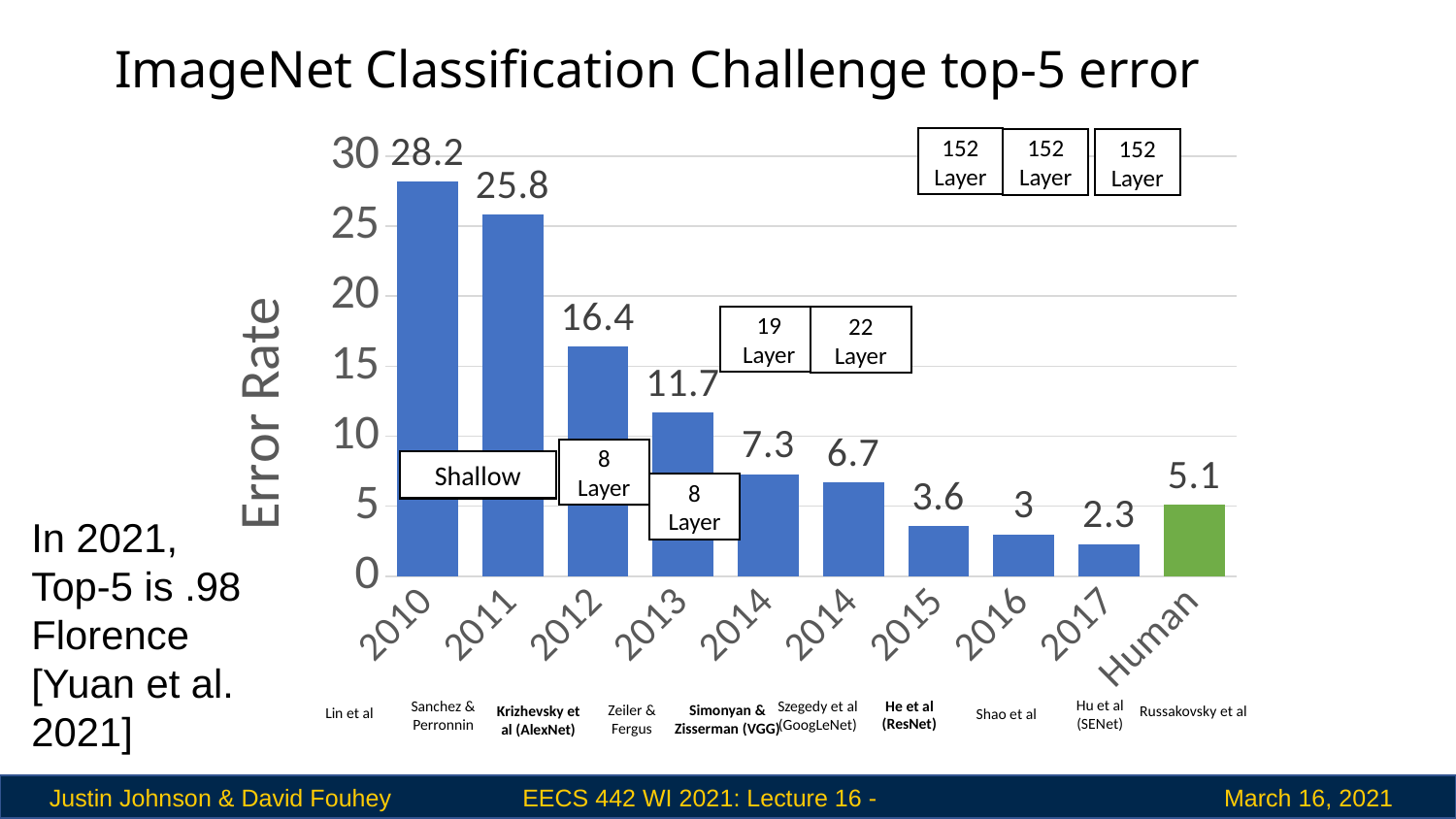
Which category has the highest error rate? 2010 Which has a higher error rate, the Simonyan & Zisserman (VGG) bar or the Szegedy et al (GoogLeNet) bar? Simonyan & Zisserman (VGG) Which category has the lowest error rate? 2017 What is the difference in error rate between 2010 and 2011? 2.4 How many bars are plotted in the chart? 10 What is the error rate for 2010 (Lin et al)? 28.2 Do the error rates generally rise or fall from 2010 to 2017? Fall What is the error rate for 2017 (Hu et al, SENet)? 2.3 What is the difference in error rate between the Human bar and 2015 (He et al, ResNet)? 1.5 What is the error rate for 2012 (Krizhevsky et al, AlexNet)? 16.4 What type of chart is shown on the slide? Bar chart What is the error rate for the Human bar? 5.1